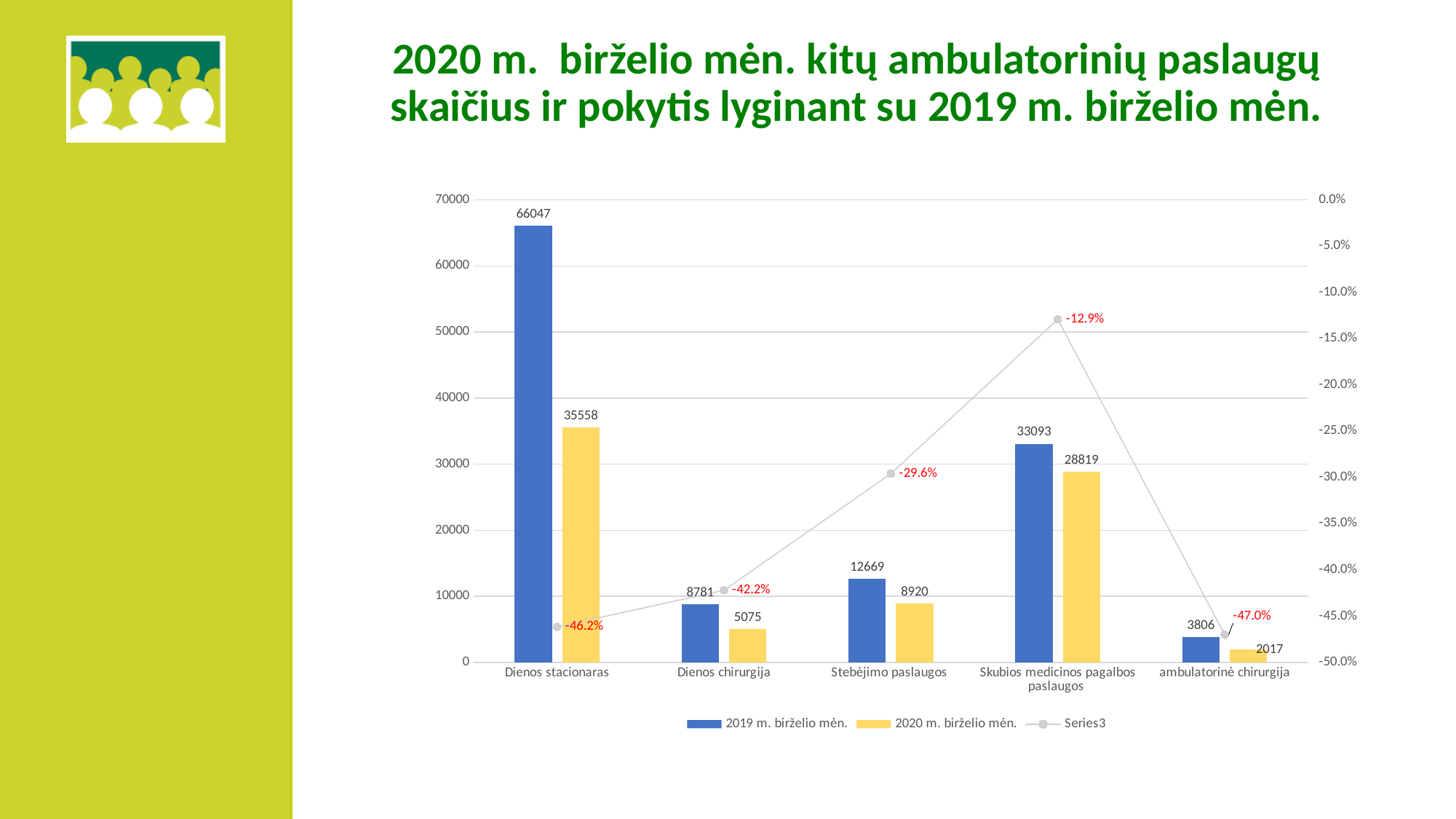
What is the value for Dienos stacionaras in the 2019 m. birželio mėn. series? 66047 Which Series3 value is the least negative (highest) across the categories? -12.9% Which category has the highest value in the 2019 m. birželio mėn. series? Dienos stacionaras How many series does the legend list? 3 What kind of chart is shown on the slide? Combined bar and line chart How many categories are shown on the x axis? 5 What is the value for Skubios medicinos pagalbos paslaugos in the 2020 m. birželio mėn. series? 28819 What is the Series3 value shown for Stebėjimo paslaugos? -29.6% What is the difference between the 2019 m. birželio mėn. and 2020 m. birželio mėn. values for Dienos stacionaras? 30489 Which category has the lowest value in the 2020 m. birželio mėn. series? ambulatorinė chirurgija Which is larger: the 2020 m. birželio mėn. value for Stebėjimo paslaugos or for Dienos chirurgija? Stebėjimo paslaugos Is the 2019 m. birželio mėn. value for Skubios medicinos pagalbos paslaugos greater or less than 30000? greater